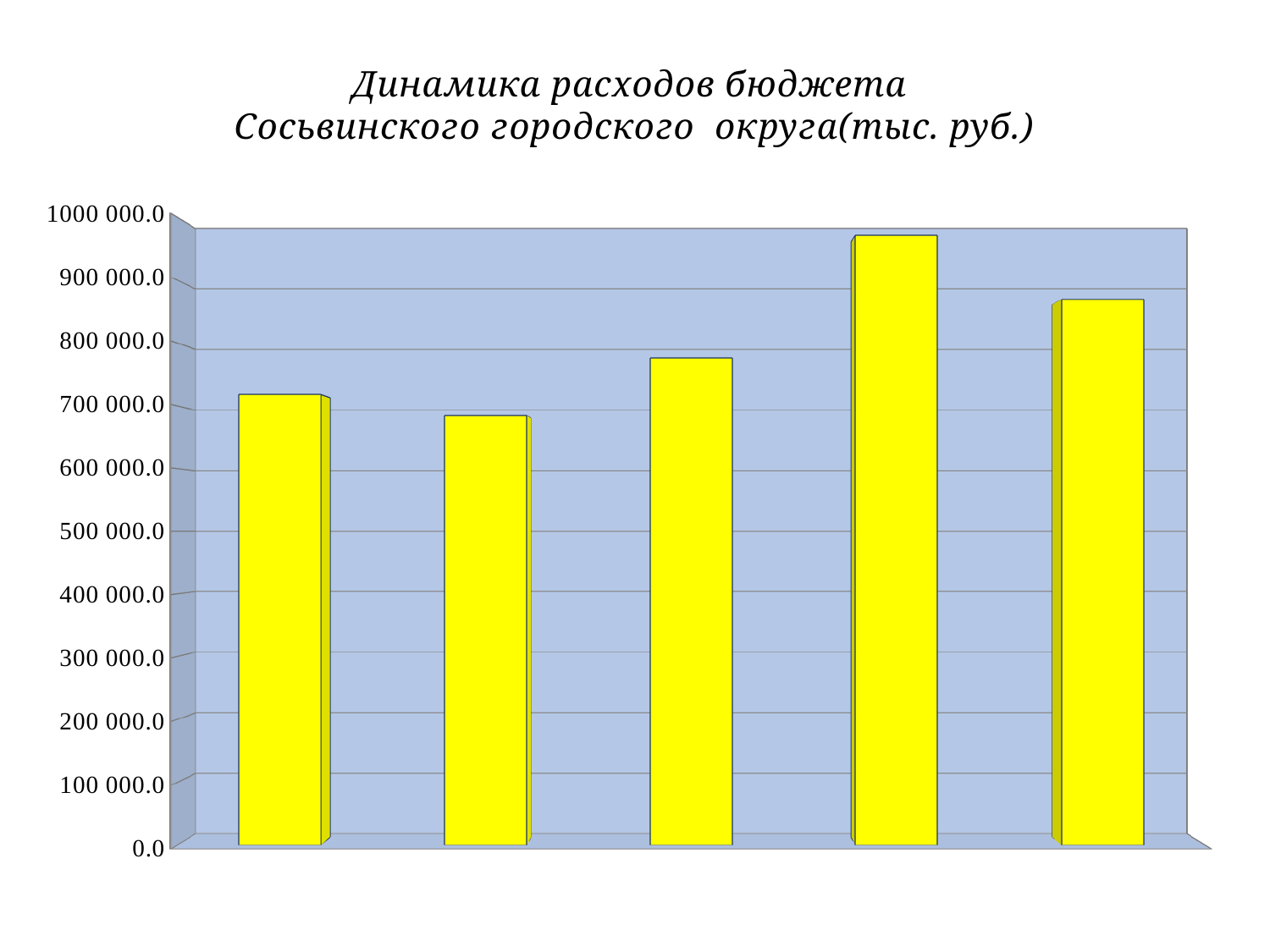
What is the title of the chart? Динамика расходов бюджета Сосьвинского городского округа(тыс. руб.) Is the value of the third bar greater or less than 700 000.0? greater How many bars are plotted in the chart? 5 Is the value of the first bar greater or less than 800 000.0? less Which is larger, the first bar or the third bar? the third bar Which bar is the shortest in the chart? the second bar Is the value of the fourth bar greater or less than 900 000.0? greater Which bar is the tallest in the chart? the fourth bar What kind of chart is shown on the slide? bar chart Which is larger, the fourth bar or the fifth bar? the fourth bar